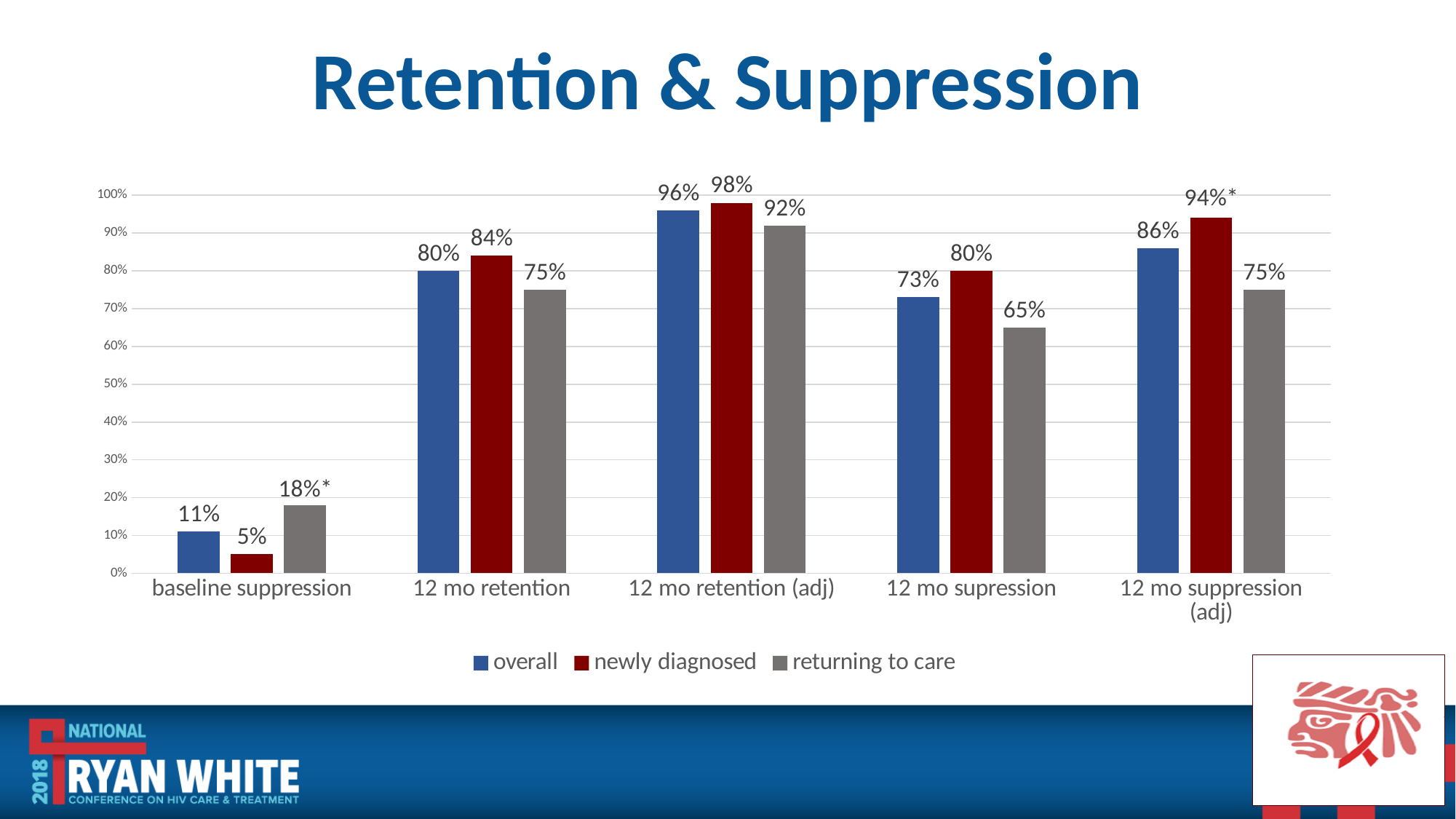
What is the value for 'overall' at 'baseline suppression'? 11% How many categories are shown on the x axis? 5 What kind of chart is shown on the slide? bar chart What is the title of the slide? Retention & Suppression What is the value for 'newly diagnosed' at '12 mo retention (adj)'? 98% Which is larger at '12 mo suppression (adj)': 'overall' or 'returning to care'? overall Which series has the lowest value at 'baseline suppression'? newly diagnosed What is the value for 'returning to care' at '12 mo supression'? 65% Which series has the highest value at '12 mo retention'? newly diagnosed How many series does the legend list? 3 What is the value for 'newly diagnosed' at '12 mo suppression (adj)'? 94%* What is the difference between 'newly diagnosed' and 'returning to care' at '12 mo supression'? 15%